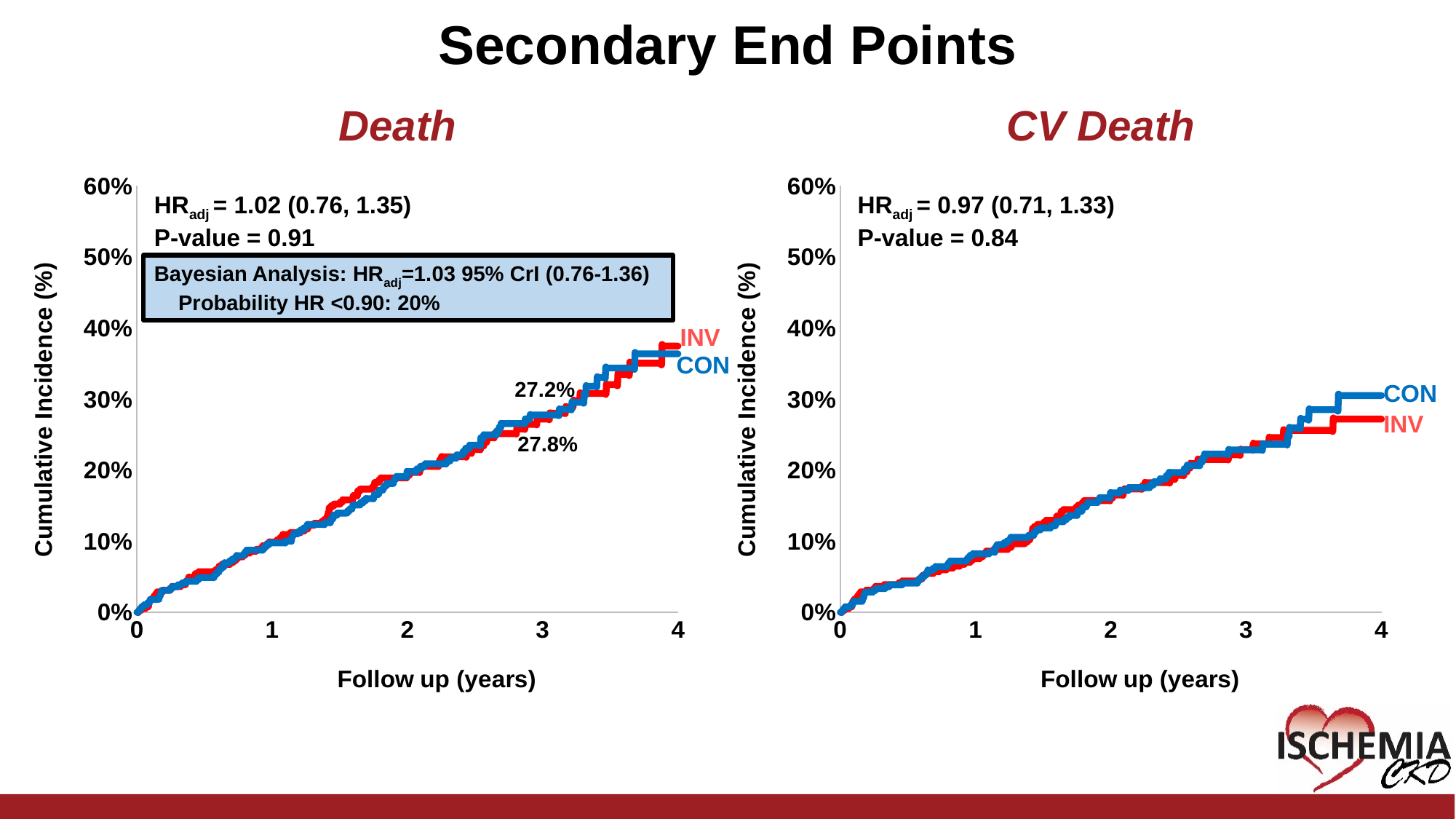
On the CV Death chart, is the value for CON at year 4 greater or less than 20%? greater On the CV Death chart, is the value for INV at year 4 greater or less than 30%? less What kind of chart is the Death chart? line chart On the Death chart, is the value for CON at year 1 greater or less than 20%? less On the Death chart, what is the Bayesian probability that HR is less than 0.90? 20% On the Death chart, do the cumulative incidence values rise or fall as follow-up years increase? rise What is the maximum follow-up value shown on the x axis of the CV Death chart? 4 How many series are plotted on the CV Death chart? 2 On the CV Death chart, which series has the higher value at year 4, CON or INV? CON On the Death chart, what is the adjusted hazard ratio with its confidence interval? 1.02 (0.76, 1.35) On the Death chart, what are the two data labels printed near year 3? 27.2% and 27.8%